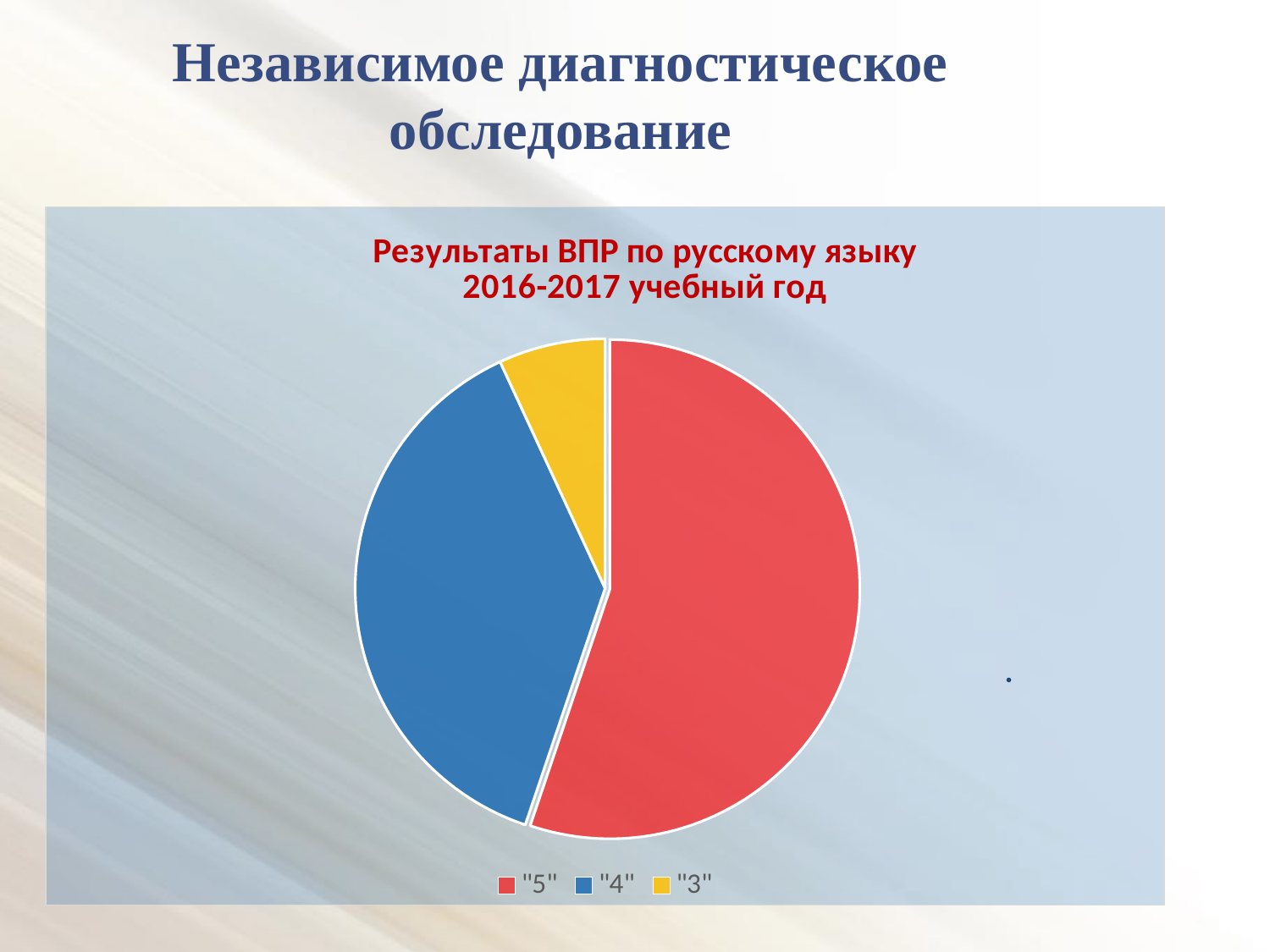
What is the title of the pie chart? Результаты ВПР по русскому языку 2016-2017 учебный год Which category has the largest slice in the pie chart? "5" How many entries does the legend of the pie chart list? 3 Which slice is larger in the pie chart, "4" or "3"? "4" What colour is the slice for "4" in the pie chart? blue Which category has the smallest slice in the pie chart? "3" What kind of chart is shown on the slide? pie chart How many slices does the pie chart have? 3 Which slice is larger in the pie chart, "5" or "4"? "5" Which slice is smaller in the pie chart, "5" or "3"? "3"